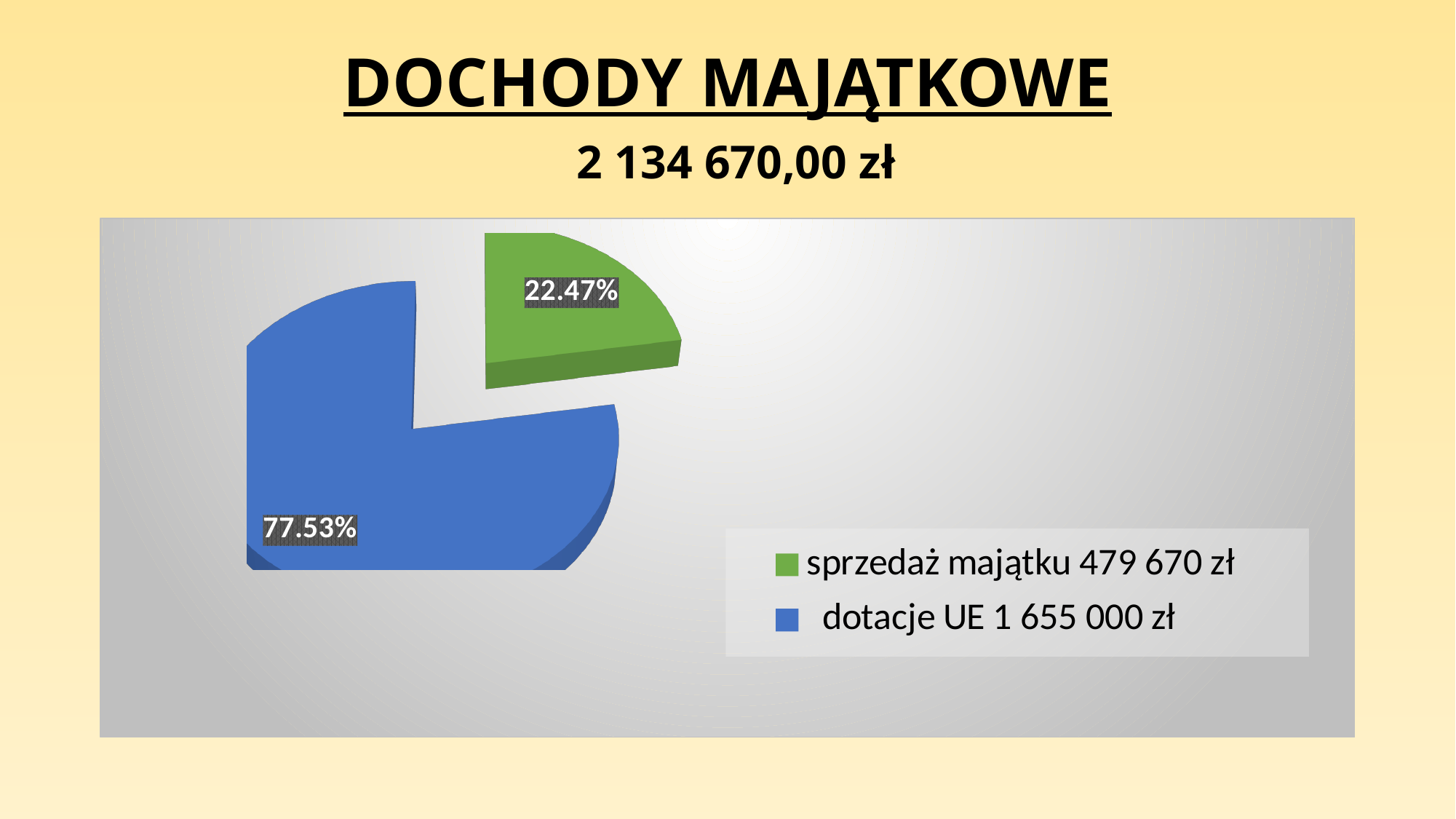
What kind of chart is shown on the slide? pie chart What value is given in the legend for 'sprzedaż majątku'? 479 670 zł Which slice of the pie is the largest? dotacje UE Which is larger, the share for 'dotacje UE' or the share for 'sprzedaż majątku'? dotacje UE What share of the pie does the 'sprzedaż majątku' slice represent? 22.47% What share of the pie does the 'dotacje UE' slice represent? 77.53% Which slice of the pie is the smallest? sprzedaż majątku What value is given in the legend for 'dotacje UE'? 1 655 000 zł What is the difference in percentage points between the 'dotacje UE' share and the 'sprzedaż majątku' share? 55.06% What is the title of the slide above the chart? DOCHODY MAJĄTKOWE How many slices does the pie chart have? 2 What colour is the 'sprzedaż majątku' slice? green